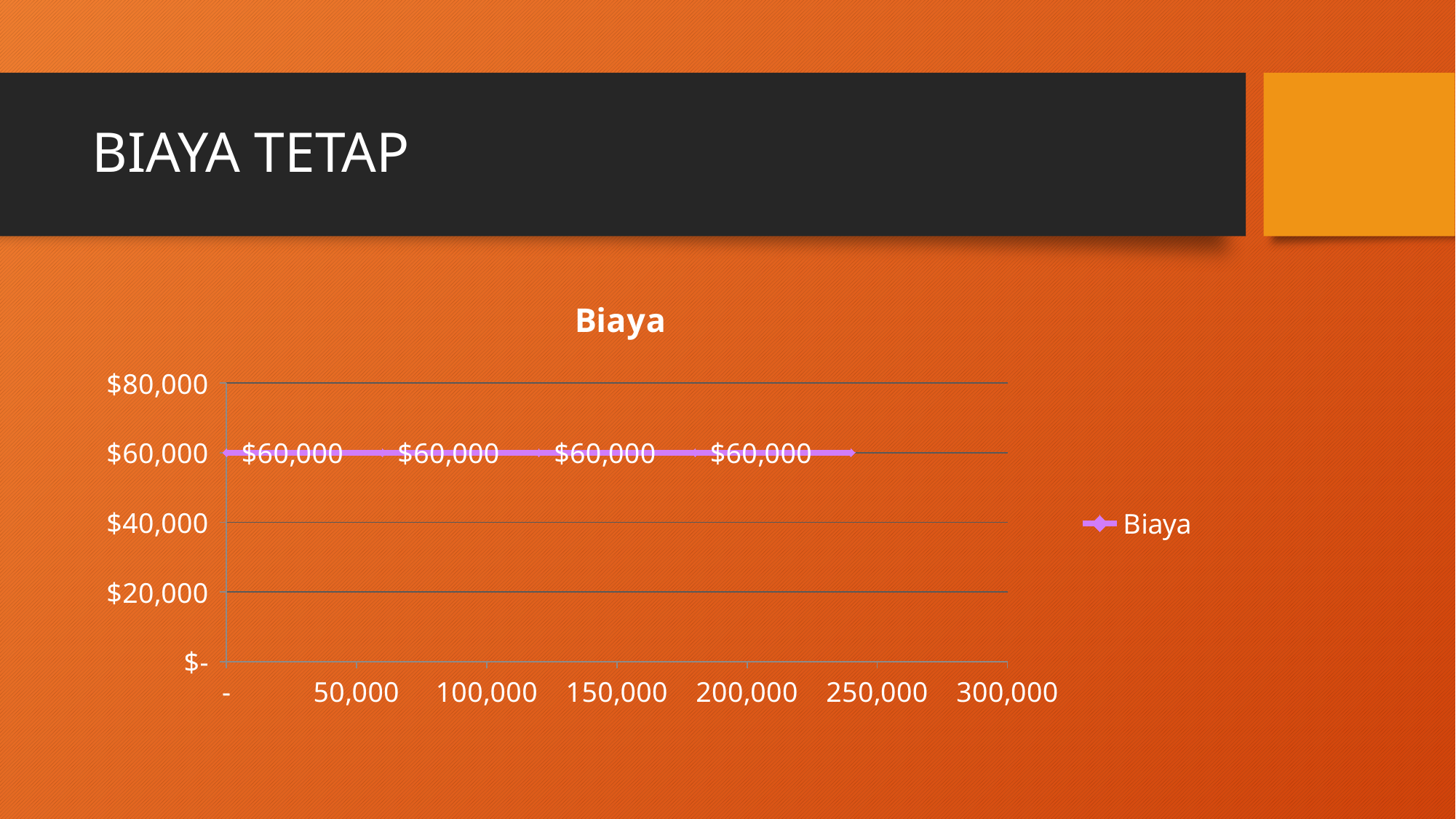
What value is shown by the data labels on the Biaya line? $60,000 Do the values of the Biaya line rise, fall, or stay constant along the x axis? stay constant What is the title of the chart? Biaya What is the name of the series shown in the legend? Biaya What is the difference between the first and last labelled values on the Biaya line? $0 What type of chart is shown on the slide? line chart Is the value of the Biaya line greater or less than $40,000? greater Is the value of the Biaya line greater or less than $80,000? less What is the highest tick value shown on the vertical axis? $80,000 What is the highest value labelled on the Biaya line? $60,000 How many series does the legend list? 1 What is the lowest value labelled on the Biaya line? $60,000